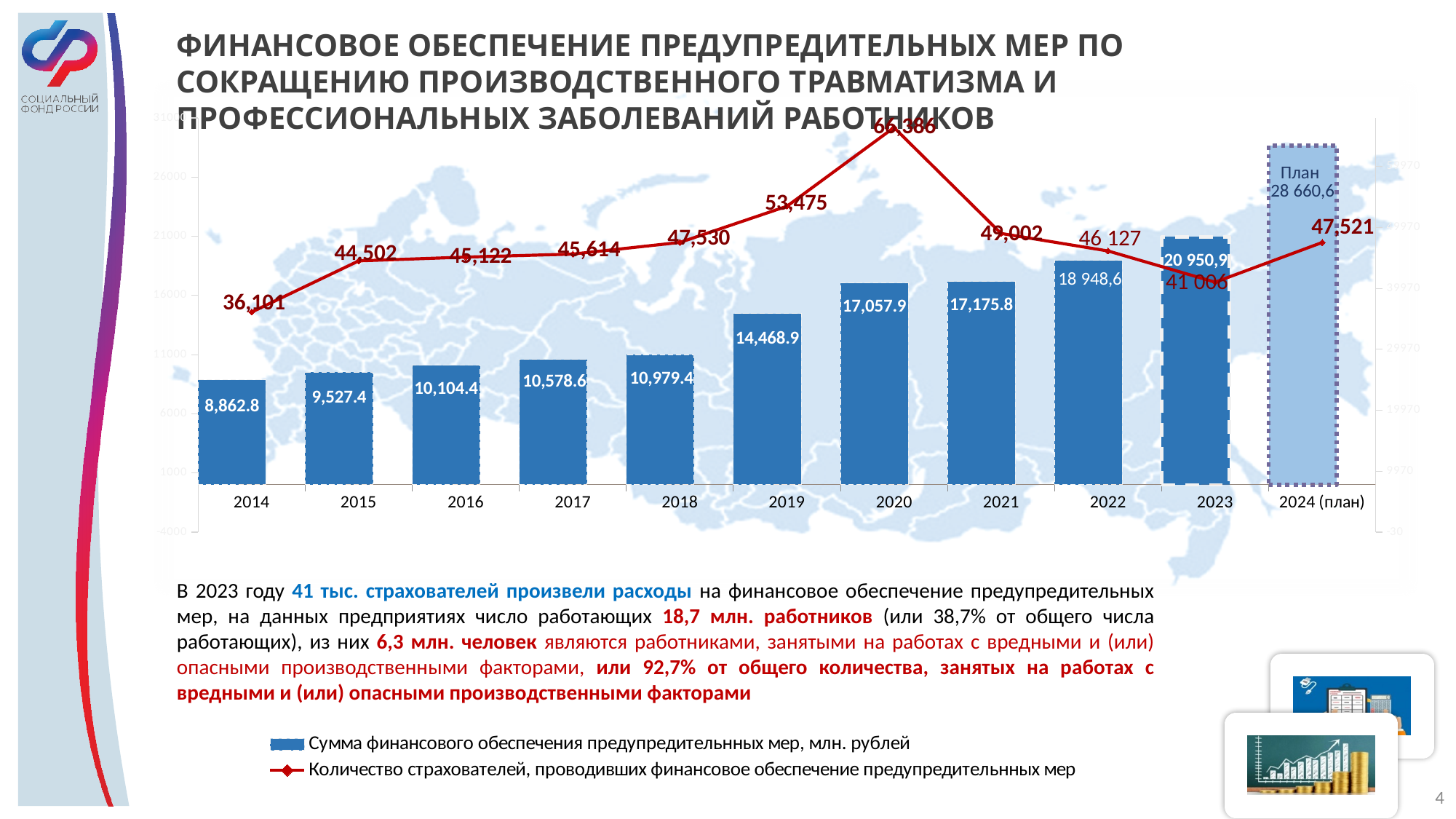
Do the bar values for the sum of financial support rise or fall from 2014 to 2024 (план)? rise What is the sum of financial support for preventive measures (bar) for 2019? 14,468.9 How many series does the chart legend list? 2 What is the difference between the bar values for 2021 and 2020? 117.9 How many insurers (line series) carried out financial support of preventive measures in 2014? 36,101 Which year has the lowest bar value for the sum of financial support? 2014 By how much did the number of insurers increase from 2014 to 2015? 8,401 What is the value of the line series (number of insurers) for 2023? 41 006 How many years (categories) are shown on the x axis of the chart? 11 Which is larger: the number of insurers in 2022 or in 2023? 2022 What is the planned sum of financial support shown for 2024 (план)? 28 660,6 In which year does the line series (number of insurers) reach its highest value? 2020